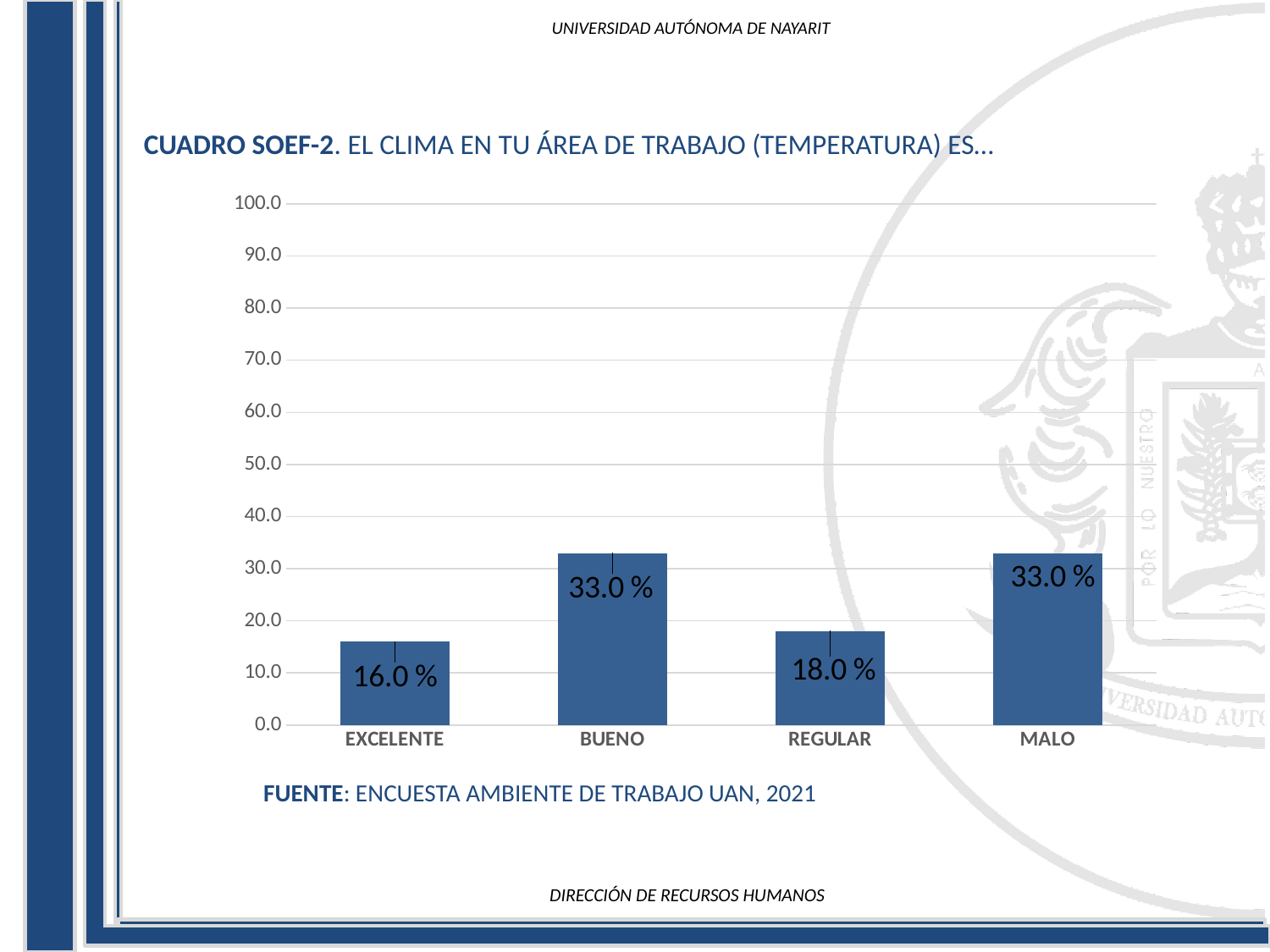
How many categories are shown on the x axis? 4 What is the value for EXCELENTE? 16.0 % Which is larger, the value for REGULAR or the value for MALO? MALO What is the value for REGULAR? 18.0 % What is the value for BUENO? 33.0 % What is the difference between the values for BUENO and EXCELENTE? 17.0 % What is the value for MALO? 33.0 % What kind of chart is shown on the slide? bar chart Which category has the lowest value? EXCELENTE What is the difference between the values for REGULAR and EXCELENTE? 2.0 % What is the source cited below the chart? ENCUESTA AMBIENTE DE TRABAJO UAN, 2021 Is the value for BUENO greater or less than 30.0? greater